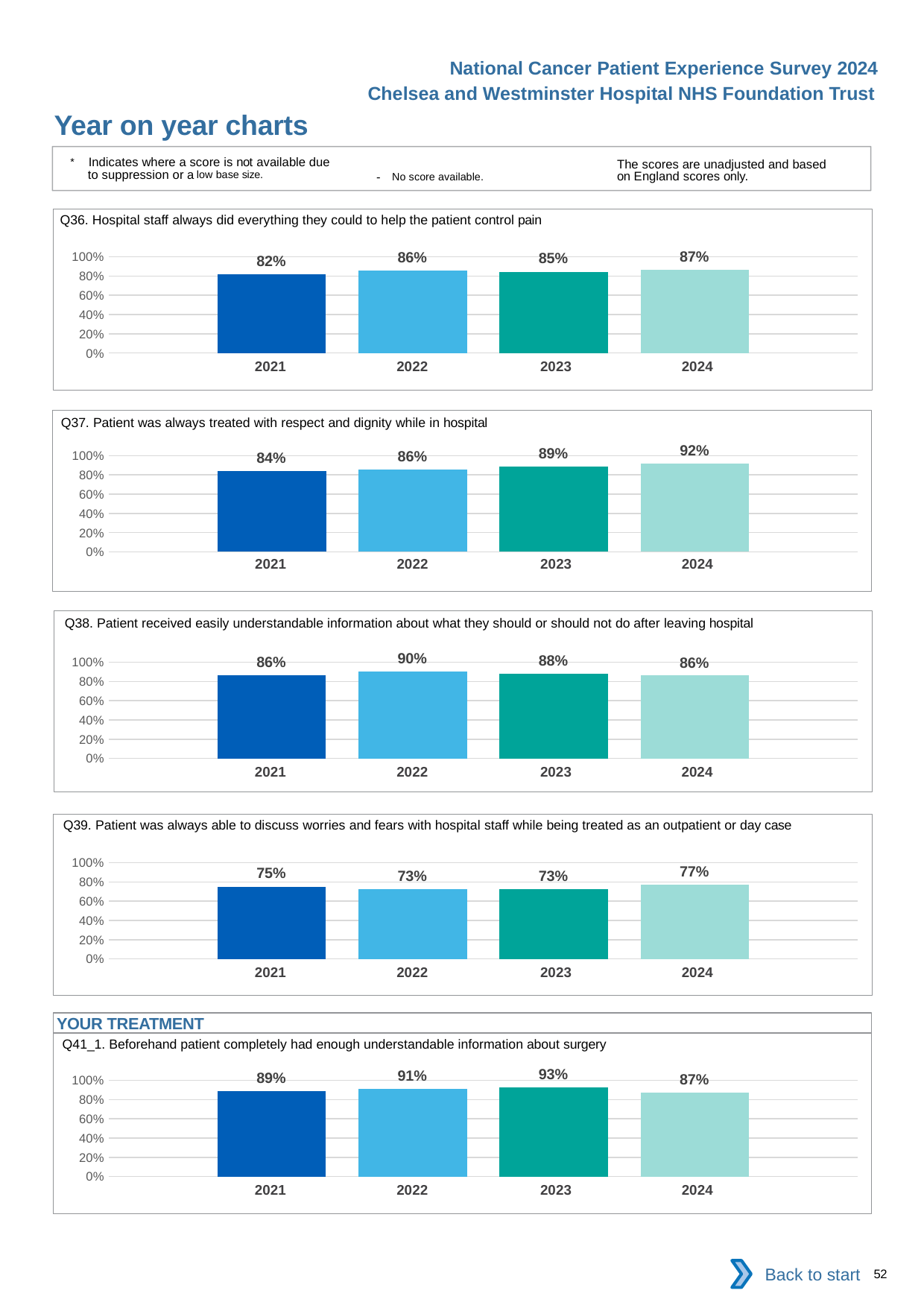
In the Q37 chart (patient was always treated with respect and dignity while in hospital), which year has the highest value? 2024 In the Q39 chart (able to discuss worries and fears as an outpatient or day case), is the value for 2021 greater or less than 80%? less What kind of chart is the Q39 chart (able to discuss worries and fears as an outpatient or day case)? bar chart In the Q41_1 chart (enough understandable information about surgery beforehand), which is larger, the 2022 value or the 2024 value? 2022 In the Q36 chart (hospital staff always did everything they could to help the patient control pain), what is the value for 2024? 87% How many years are plotted in the Q36 chart (hospital staff always did everything they could to help the patient control pain)? 4 In the Q37 chart (patient was always treated with respect and dignity while in hospital), do the values rise or fall from 2021 to 2024? rise In the Q38 chart (easily understandable information about what to do after leaving hospital), what is the value for 2023? 88% In the Q41_1 chart (enough understandable information about surgery beforehand), which year has the highest value? 2023 In the Q39 chart (able to discuss worries and fears as an outpatient or day case), which year has the lowest value? 2022 and 2023 (both 73%) In the Q37 chart (patient was always treated with respect and dignity while in hospital), what is the difference between the 2024 and 2021 values? 8 percentage points In the Q38 chart (easily understandable information about what to do after leaving hospital), which year has the highest value? 2022